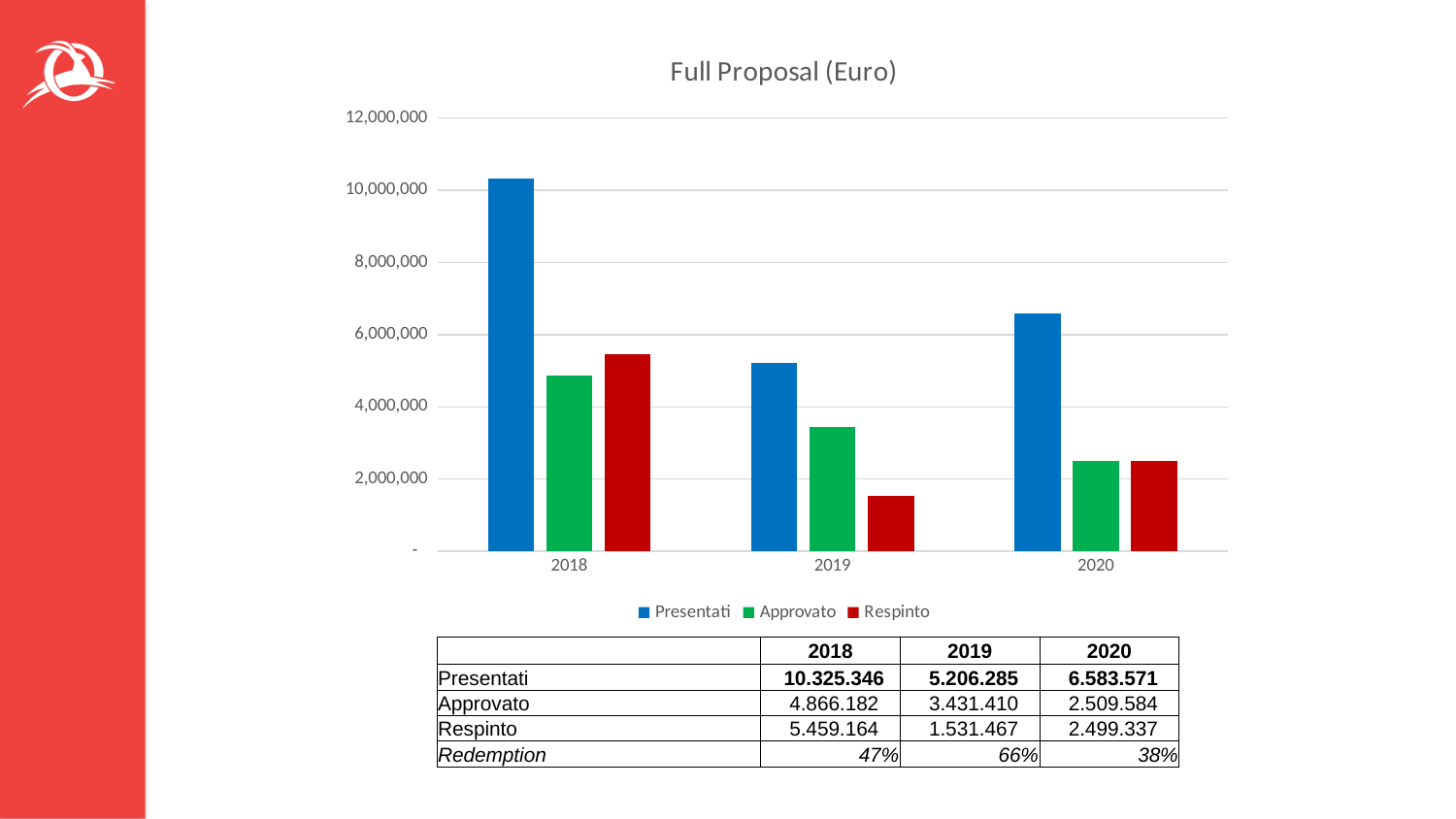
What is the title of the chart? Full Proposal (Euro) How many series does the chart legend list? 3 Is the Presentati value for 2020 greater or less than 6,000,000? greater What is the Respinto value for 2020? 2.499.337 How many years (categories) are shown on the x axis of the chart? 3 In which year is the Presentati value highest? 2018 In which year is the Respinto value lowest? 2019 Which is larger in 2018, Approvato or Respinto? Respinto What is the Presentati value for 2018? 10.325.346 What is the Approvato value for 2019? 3.431.410 What is the difference between the Presentati values for 2018 and 2019? 5.119.061 What type of chart is shown on the slide? bar chart